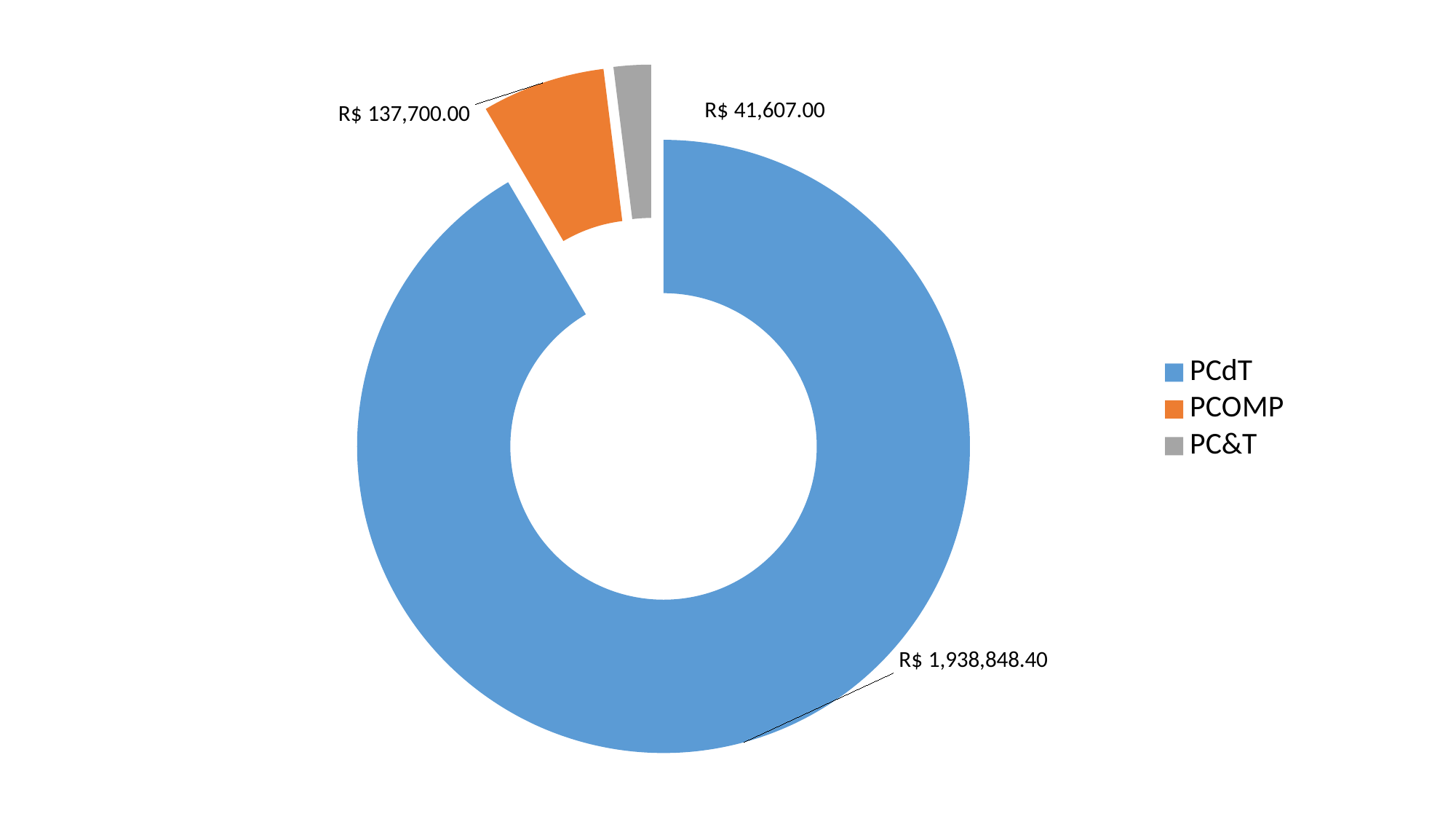
Which is larger, the value for PCOMP or the value for PC&T? PCOMP What kind of chart is shown on the slide? doughnut chart What is the difference between the values for PCdT and PCOMP? R$ 1,801,148.40 How many categories are shown in the chart? 3 Which colour represents PCOMP in the legend? orange Which category has the largest value? PCdT What is the value for PCOMP? R$ 137,700.00 What is the total of all three values in the chart? R$ 2,118,155.40 What is the value for PCdT? R$ 1,938,848.40 What is the value for PC&T? R$ 41,607.00 What is the difference between the values for PCOMP and PC&T? R$ 96,093.00 Which category has the smallest value? PC&T